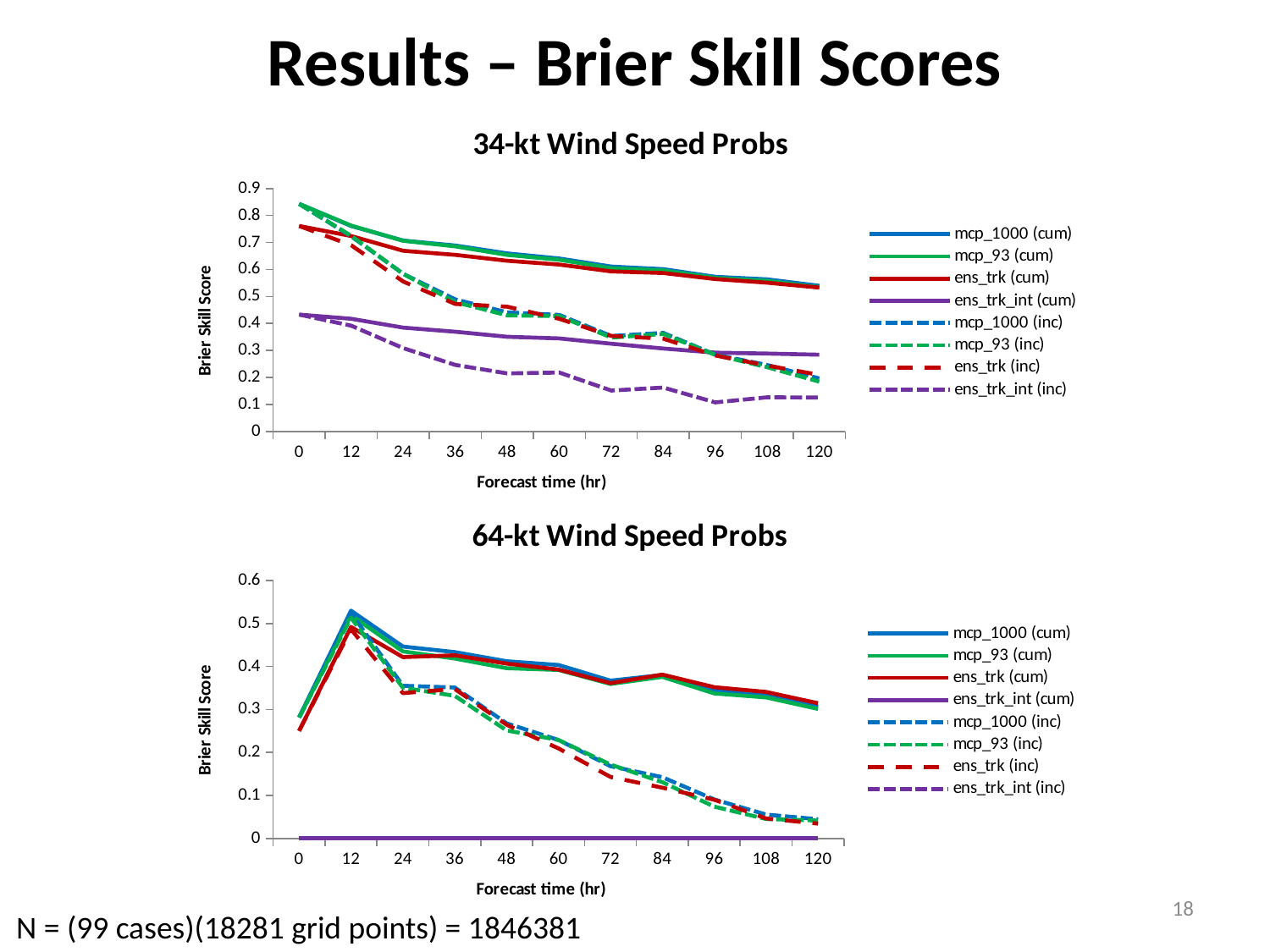
In the "34-kt Wind Speed Probs" chart, which series has the lowest value at 120 hr? ens_trk_int (inc) How many series does the legend of the "64-kt Wind Speed Probs" chart list? 8 What kind of chart is the "34-kt Wind Speed Probs" chart? line chart In the "34-kt Wind Speed Probs" chart, at 0 hr, which is larger: mcp_93 (cum) or ens_trk (cum)? mcp_93 (cum) How many forecast-time points are labelled on the x axis of the "34-kt Wind Speed Probs" chart? 11 What is the y-axis label of the "64-kt Wind Speed Probs" chart? Brier Skill Score In the "34-kt Wind Speed Probs" chart, is the value of ens_trk (cum) at 120 hr greater or less than 0.5? greater In the "64-kt Wind Speed Probs" chart, does the mcp_1000 (inc) series rise or fall between 36 hr and 120 hr? fall In the "64-kt Wind Speed Probs" chart, is the value of mcp_1000 (cum) at 12 hr greater or less than 0.5? greater In the "34-kt Wind Speed Probs" chart, does the ens_trk (cum) series rise or fall as forecast time increases? fall In the "64-kt Wind Speed Probs" chart, what is the value of ens_trk_int (cum) at 120 hr? 0 In the "34-kt Wind Speed Probs" chart, is the value of mcp_93 (cum) at 0 hr greater or less than 0.8? greater